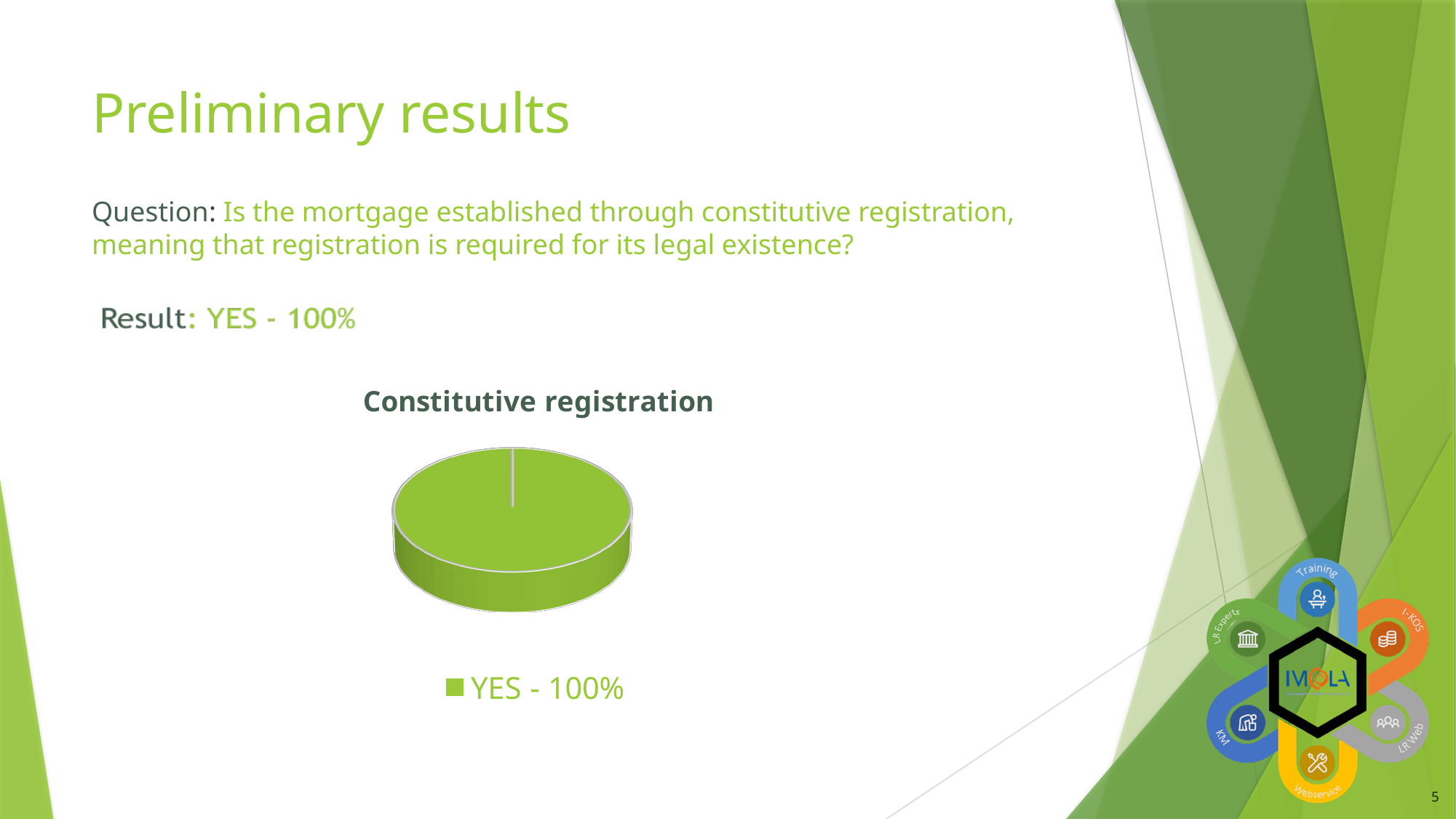
What share of the pie does the YES slice take? 100% How many slices does the pie chart have? 1 Is the share for YES greater or less than 50%? greater What is the legend entry for the chart? YES - 100% What is the title of the chart? Constitutive registration What kind of chart is shown on the slide? pie chart How many entries does the chart legend list? 1